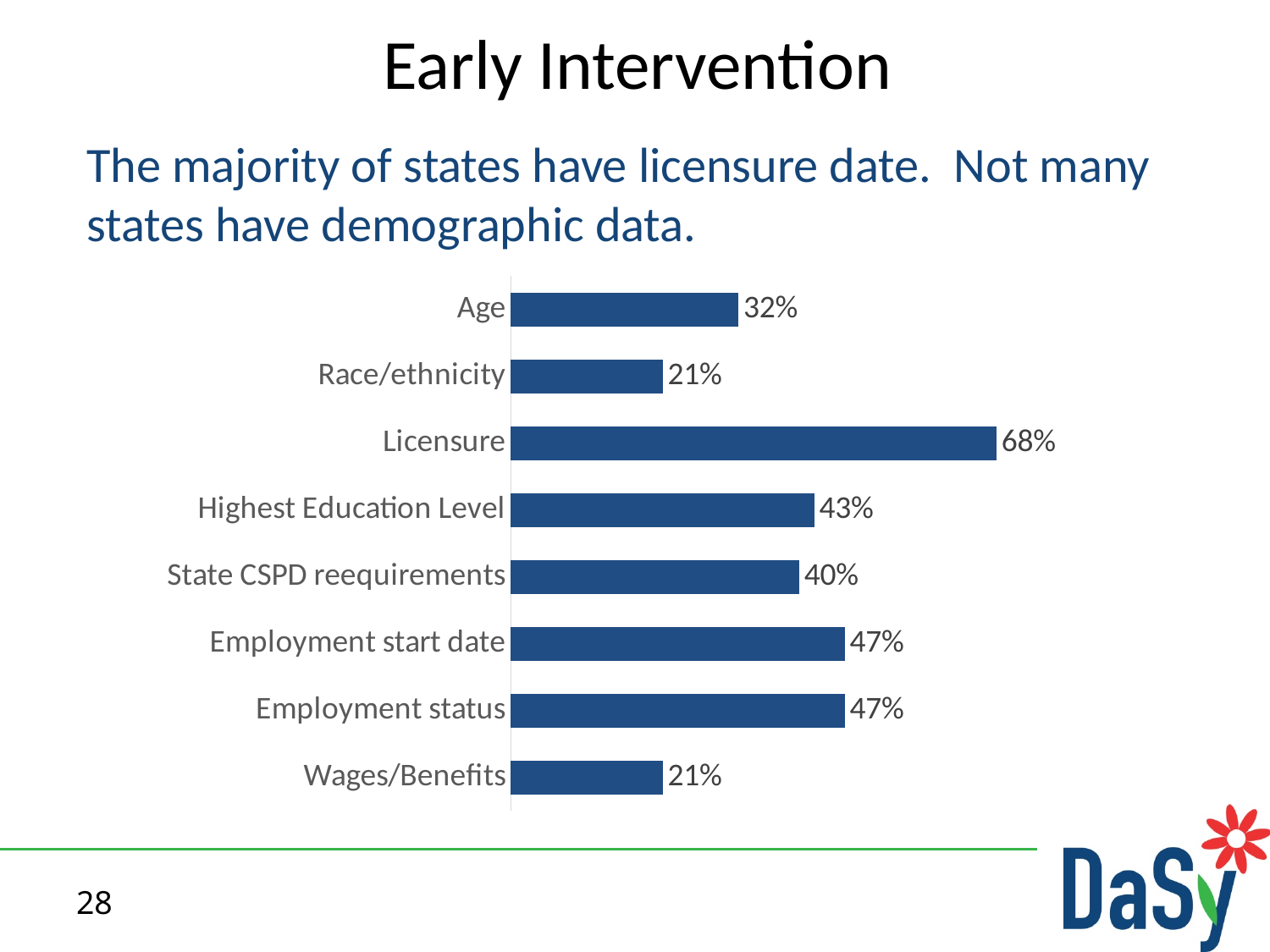
Which category has the highest value? Licensure What kind of chart is shown on the slide? Bar chart What is the difference between the values for Employment start date and Age? 15% What is the value for State CSPD reequirements? 40% What is the value for Licensure? 68% What is the value for Highest Education Level? 43% Which is larger, the value for Highest Education Level or the value for State CSPD reequirements? Highest Education Level What is the difference between the values for Licensure and Race/ethnicity? 47% How many categories are shown in the chart? 8 Which is larger, the value for Age or the value for Wages/Benefits? Age What is the value for Age? 32% What is the title of the slide? Early Intervention